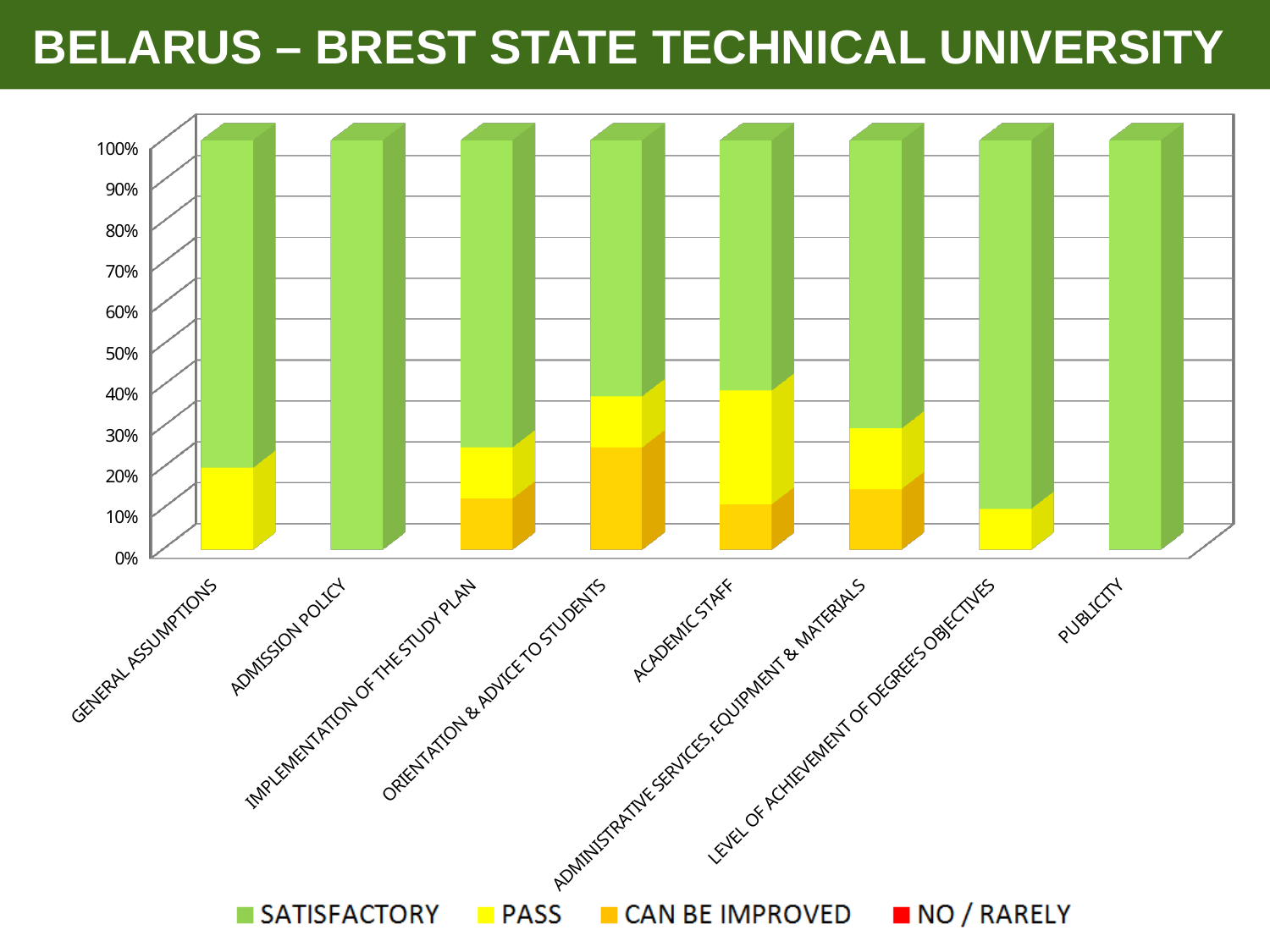
What is the SATISFACTORY value for ADMISSION POLICY? 100% How many categories are shown along the x axis of the chart? 8 Is the PASS value for LEVEL OF ACHIEVEMENT OF DEGREE'S OBJECTIVES greater or less than 20%? less Is the PASS value for GENERAL ASSUMPTIONS greater or less than 10%? greater Is the CAN BE IMPROVED value for ACADEMIC STAFF greater or less than 20%? less How many series does the chart legend list? 4 What is the SATISFACTORY value for PUBLICITY? 100% What kind of chart is shown on the slide? Stacked bar chart Which category has the largest CAN BE IMPROVED segment? ORIENTATION & ADVICE TO STUDENTS Which category has the larger CAN BE IMPROVED segment, ORIENTATION & ADVICE TO STUDENTS or ACADEMIC STAFF? ORIENTATION & ADVICE TO STUDENTS Which series in the legend does not appear in any of the bars? NO / RARELY